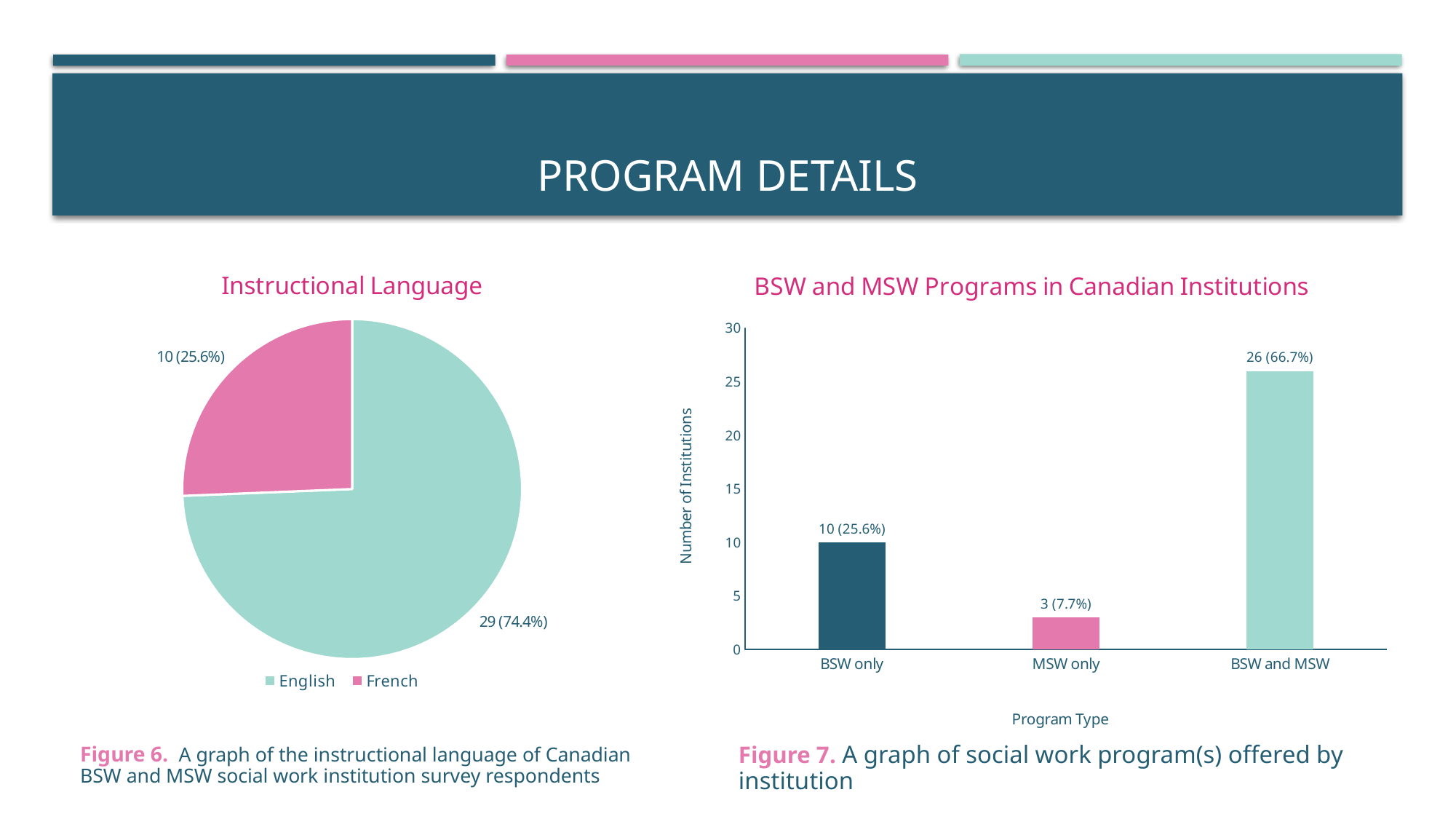
In the 'Instructional Language' chart, what is the data label for the French slice? 10 (25.6%) In the 'BSW and MSW Programs in Canadian Institutions' chart, what is the value for 'MSW only'? 3 (7.7%) In the 'BSW and MSW Programs in Canadian Institutions' chart, what is the difference in number of institutions between 'BSW and MSW' and 'BSW only'? 16 In the 'BSW and MSW Programs in Canadian Institutions' chart, what is the value for 'BSW and MSW'? 26 (66.7%) What kind of chart is the 'BSW and MSW Programs in Canadian Institutions' chart? Bar chart In the 'Instructional Language' chart, what is the data label for the English slice? 29 (74.4%) In the 'Instructional Language' chart, what share of the pie does French represent? 25.6% In the 'Instructional Language' chart, which language has the larger slice? English How many categories are shown on the x axis of the 'BSW and MSW Programs in Canadian Institutions' chart? 3 In the 'BSW and MSW Programs in Canadian Institutions' chart, which program type has the lowest number of institutions? MSW only What kind of chart is the 'Instructional Language' chart? Pie chart How many entries does the legend of the 'Instructional Language' chart list? 2